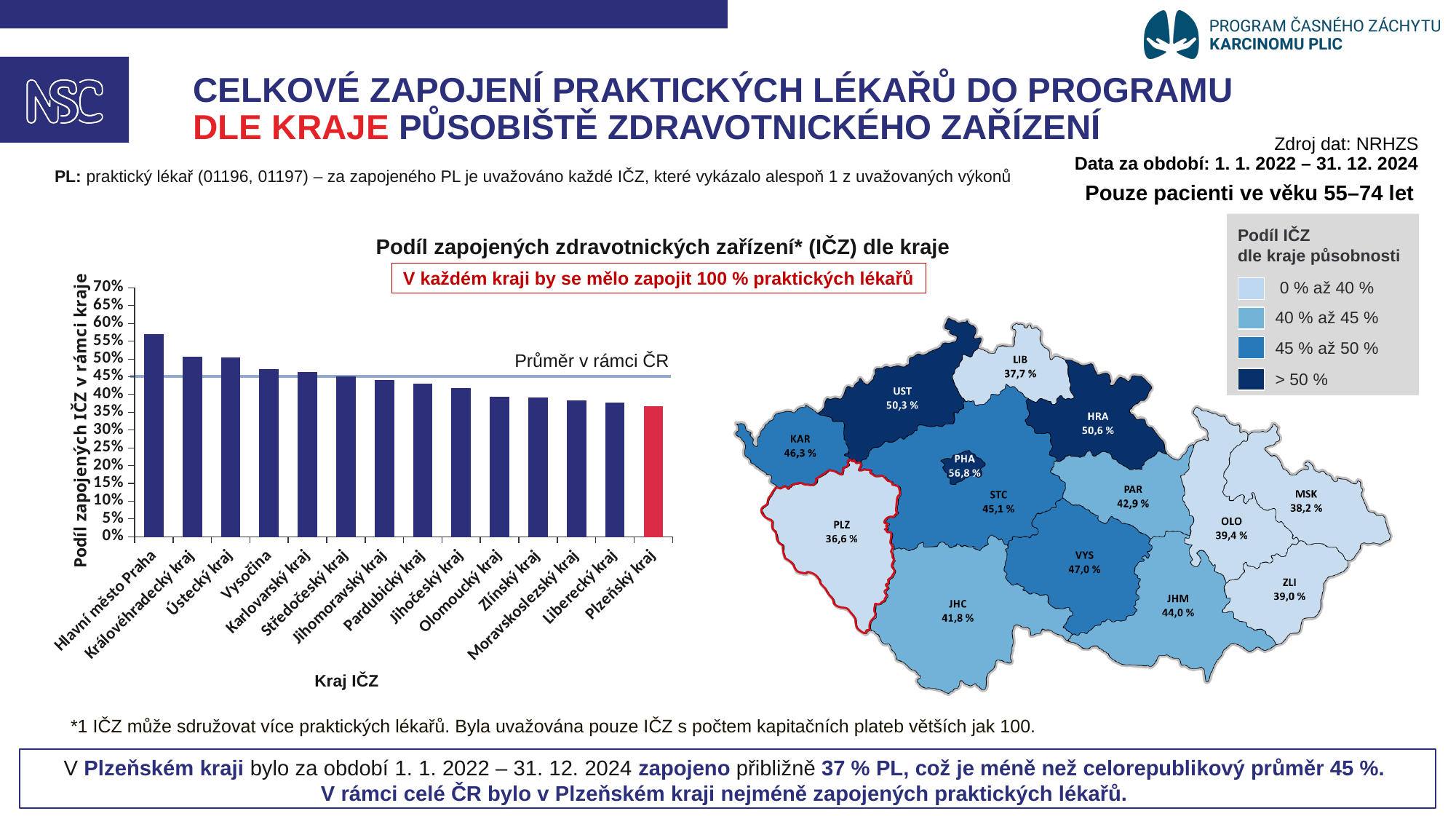
On the map, what value is shown for PLZ? 36,6 % In the bar chart, what colour is the bar for Plzeňský kraj? red On the map, what value is shown for PHA? 56,8 % In the bar chart, is the value for Jihočeský kraj greater or less than 45%? less How many regions are shown on the x axis of the bar chart? 14 In the bar chart, which region has the lowest share of involved IČZ? Plzeňský kraj What kind of chart is the chart titled 'Podíl zapojených zdravotnických zařízení* (IČZ) dle kraje'? bar chart In the bar chart, is the value for Hlavní město Praha greater or less than 50%? greater In the bar chart, which region has the highest share of involved IČZ? Hlavní město Praha In the bar chart, is the value for Plzeňský kraj greater or less than 40%? less In the bar chart, which is larger: the value for Karlovarský kraj or the value for Jihočeský kraj? Karlovarský kraj Do the bars in the bar chart rise or fall from left to right along the x axis? fall